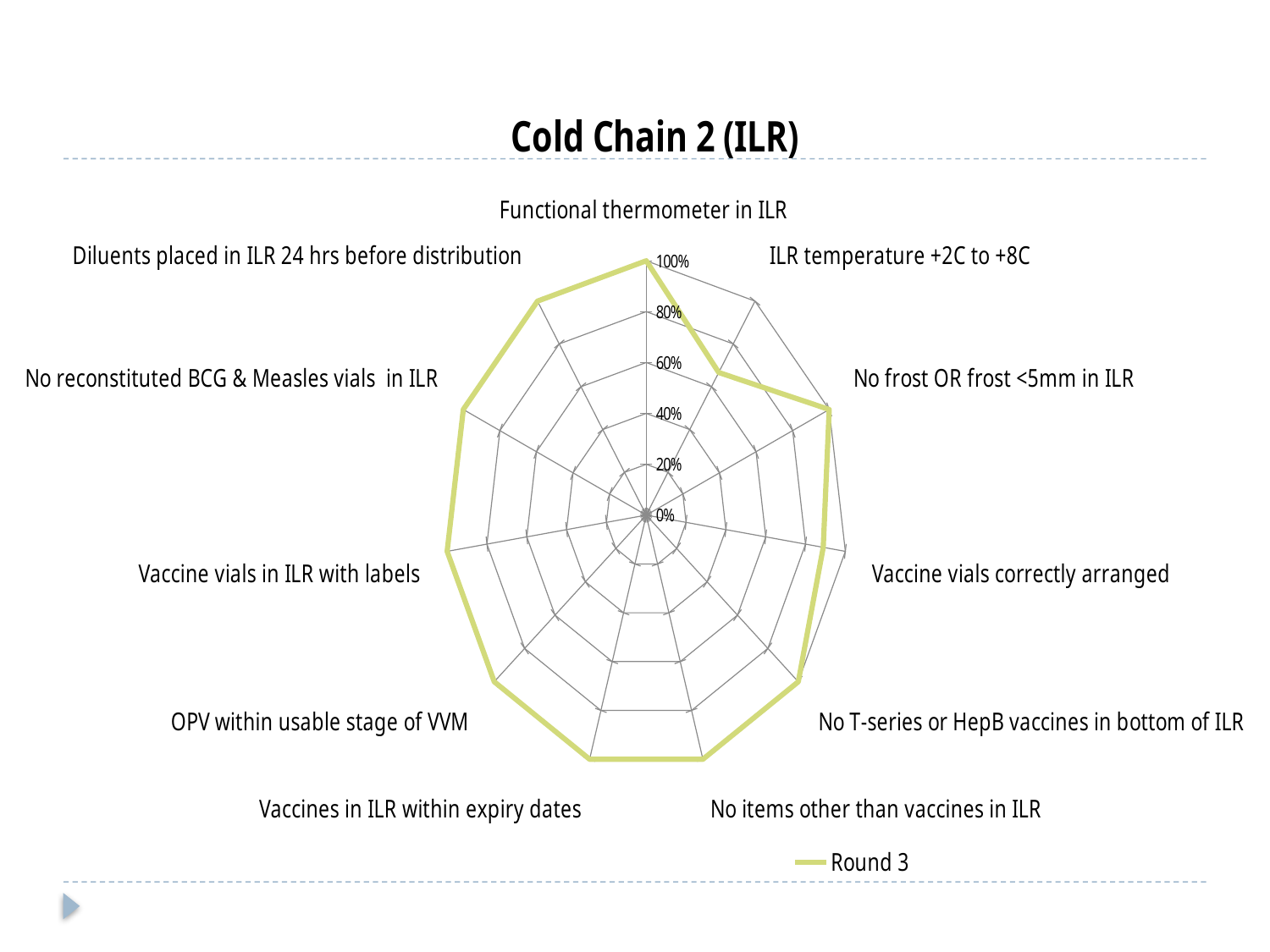
Is the value for ILR temperature +2C to +8C greater or less than 80%? less Is the value for Vaccines in ILR within expiry dates greater or less than 60%? greater What series name is shown in the legend? Round 3 Which category has the lowest value in the chart? ILR temperature +2C to +8C How many categories (axes) does the radar chart have? 11 Is the value for Functional thermometer in ILR greater or less than 80%? greater Which is larger: the value for ILR temperature +2C to +8C or the value for OPV within usable stage of VVM? OPV within usable stage of VVM What kind of chart is shown on the slide? Radar chart Which is larger: the value for Functional thermometer in ILR or the value for ILR temperature +2C to +8C? Functional thermometer in ILR How many series does the legend list? 1 What is the title of the chart? Cold Chain 2 (ILR)